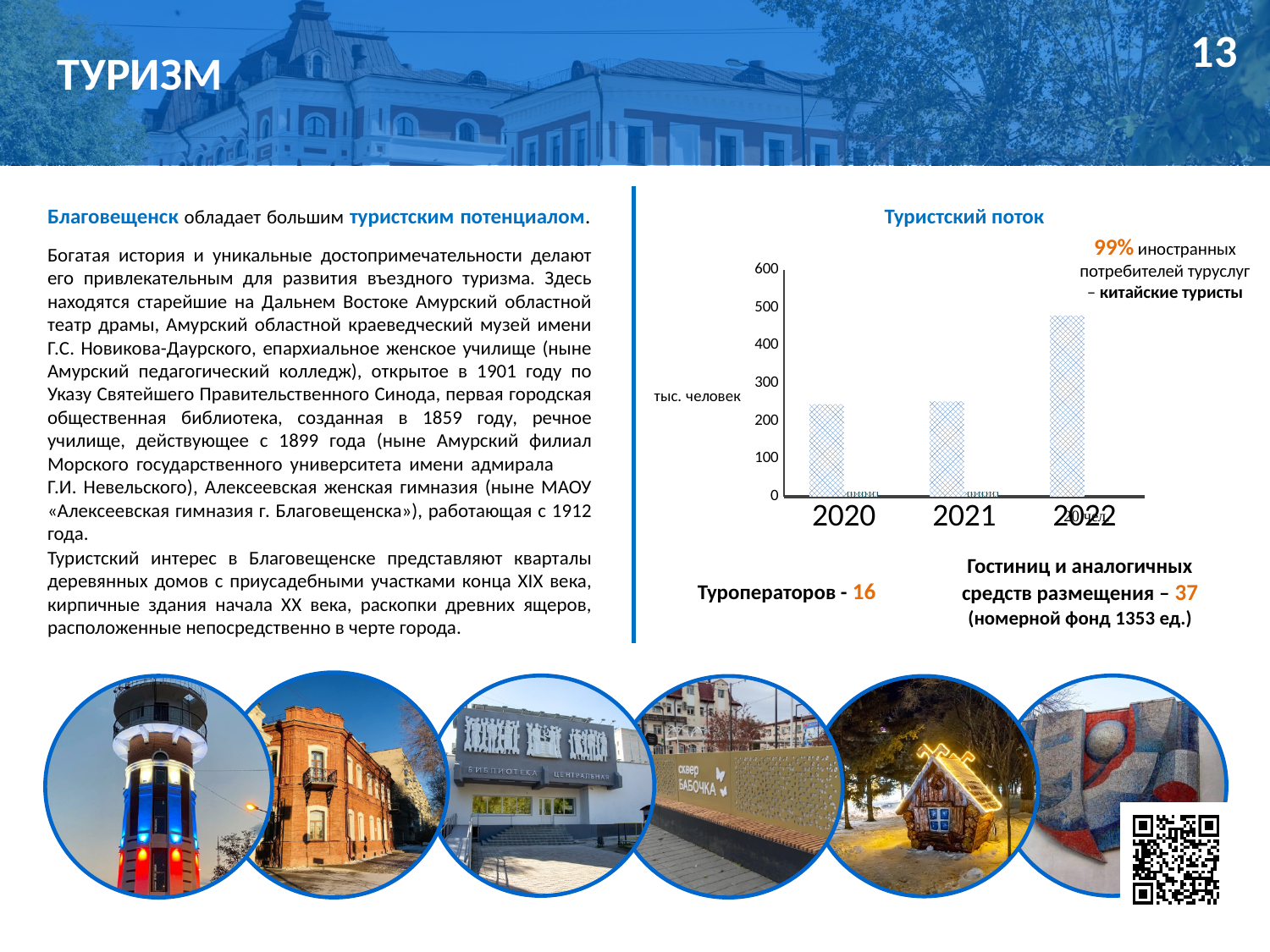
In the Туристский поток chart, which is larger, the value for 2020 or the value for 2022? 2022 In the Туристский поток chart, is the value for 2020 greater or less than 300? less In the Туристский поток chart, is the value for 2022 greater or less than 500? less What is the highest tick value shown on the vertical axis of the Туристский поток chart? 600 What is the title of the chart on the slide? Туристский поток How many years are shown on the x axis of the Туристский поток chart? 3 In the Туристский поток chart, is the value for 2021 greater or less than 200? greater What unit is labelled on the vertical axis of the Туристский поток chart? тыс. человек Do the values in the Туристский поток chart rise or fall from 2020 to 2022? rise What kind of chart is used to show the tourist flow (Туристский поток)? bar chart Which year has the highest bar in the Туристский поток chart? 2022